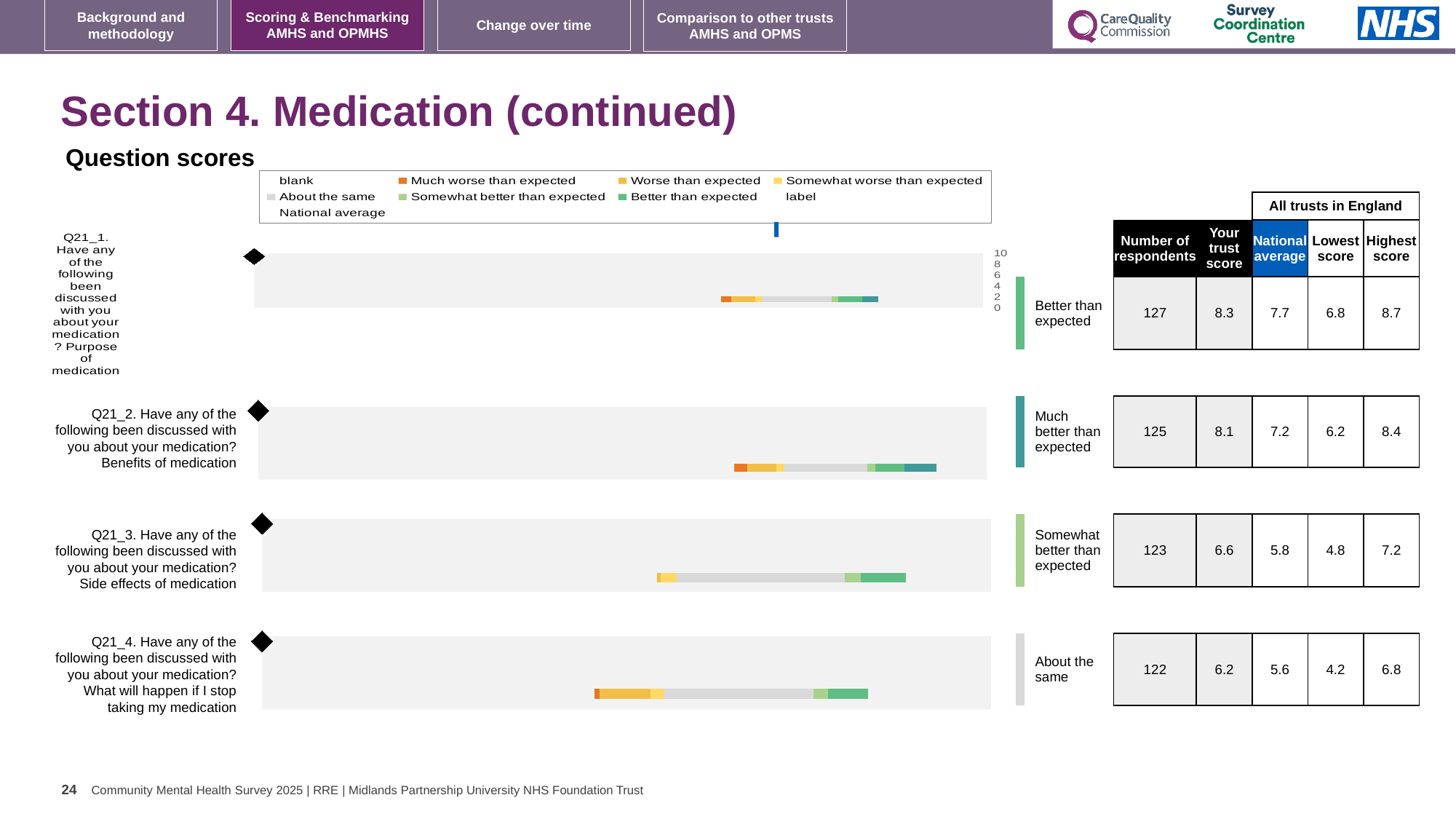
Which question has the lowest trust score in the table beside the chart? Q21_4 (What will happen if I stop taking my medication) How many respondents answered Q21_4 (What will happen if I stop taking my medication)? 122 What is the highest score among all trusts in England for Q21_2 (Benefits of medication)? 8.4 What kind of chart is used to show the question scores on this slide? bar chart What is the difference between the trust score and the national average for Q21_1? 0.6 According to the table beside the chart, what is the trust score for Q21_1 (Purpose of medication)? 8.3 According to the table beside the chart, what is the national average for Q21_3 (Side effects of medication)? 5.8 Which question has the highest trust score in the table beside the chart? Q21_1 (Purpose of medication) What benchmark category label is shown next to the bar for Q21_2 (Benefits of medication)? Much better than expected For Q21_2, which is larger: the trust score or the national average? the trust score What benchmark category label is shown next to the bar for Q21_4 (What will happen if I stop taking my medication)? About the same How many questions (categories) are plotted in the question scores chart? 4